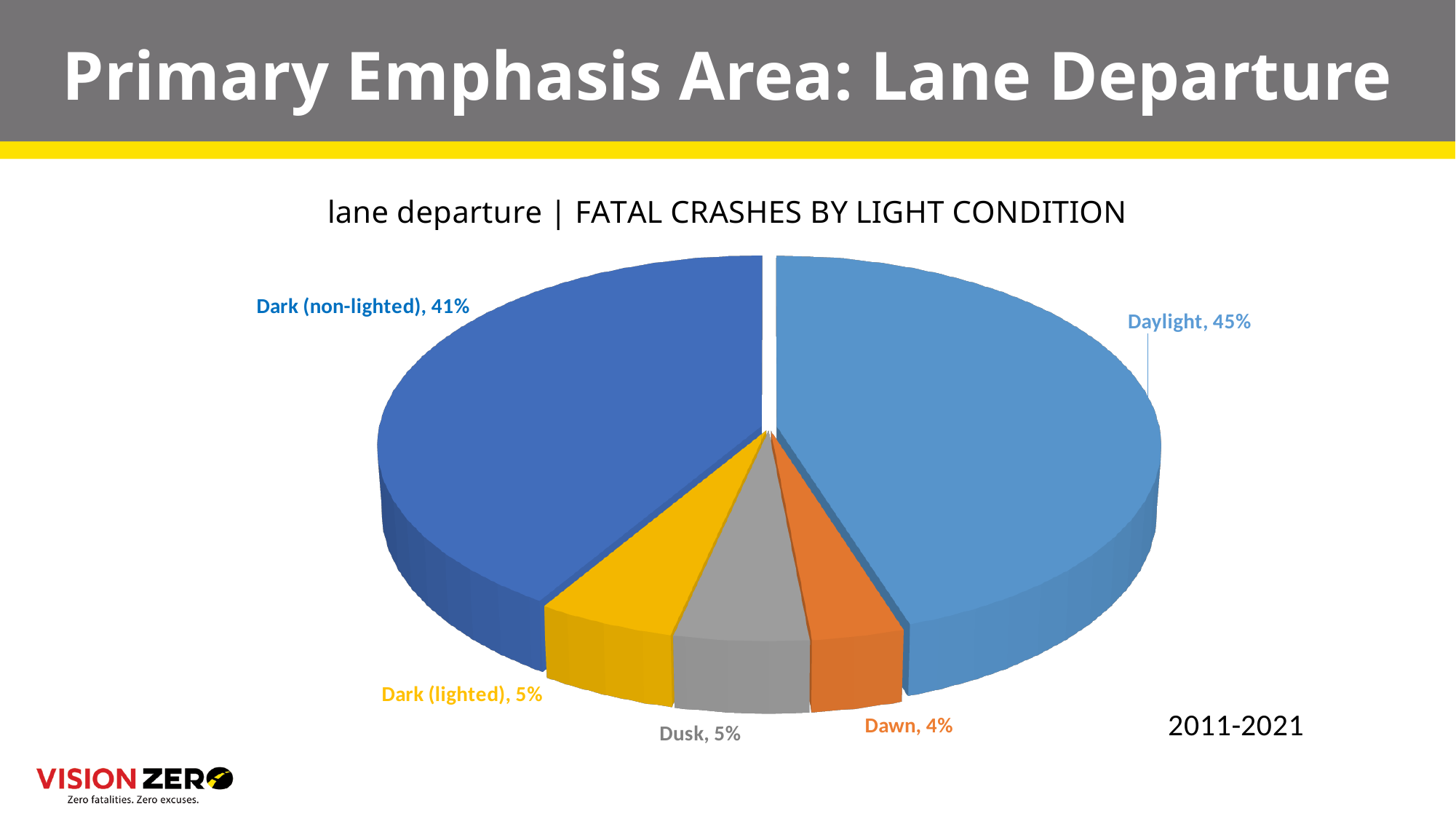
What share of lane departure fatal crashes occurred in Dark (non-lighted) conditions? 41% Which is larger, the share for Dusk or the share for Dawn? Dusk What is the difference in percentage points between the Daylight and Dark (non-lighted) shares? 4 Which light condition has the largest share of lane departure fatal crashes? Daylight What share of lane departure fatal crashes occurred in Dark (lighted) conditions? 5% What share of lane departure fatal crashes occurred at Dawn? 4% How many light condition categories are shown in the pie chart? 5 What kind of chart is shown on the slide? Pie chart What year range does the chart cover? 2011-2021 What share of lane departure fatal crashes occurred in Daylight? 45% What is the title of the chart? lane departure | FATAL CRASHES BY LIGHT CONDITION Which light condition has the smallest share of lane departure fatal crashes? Dawn